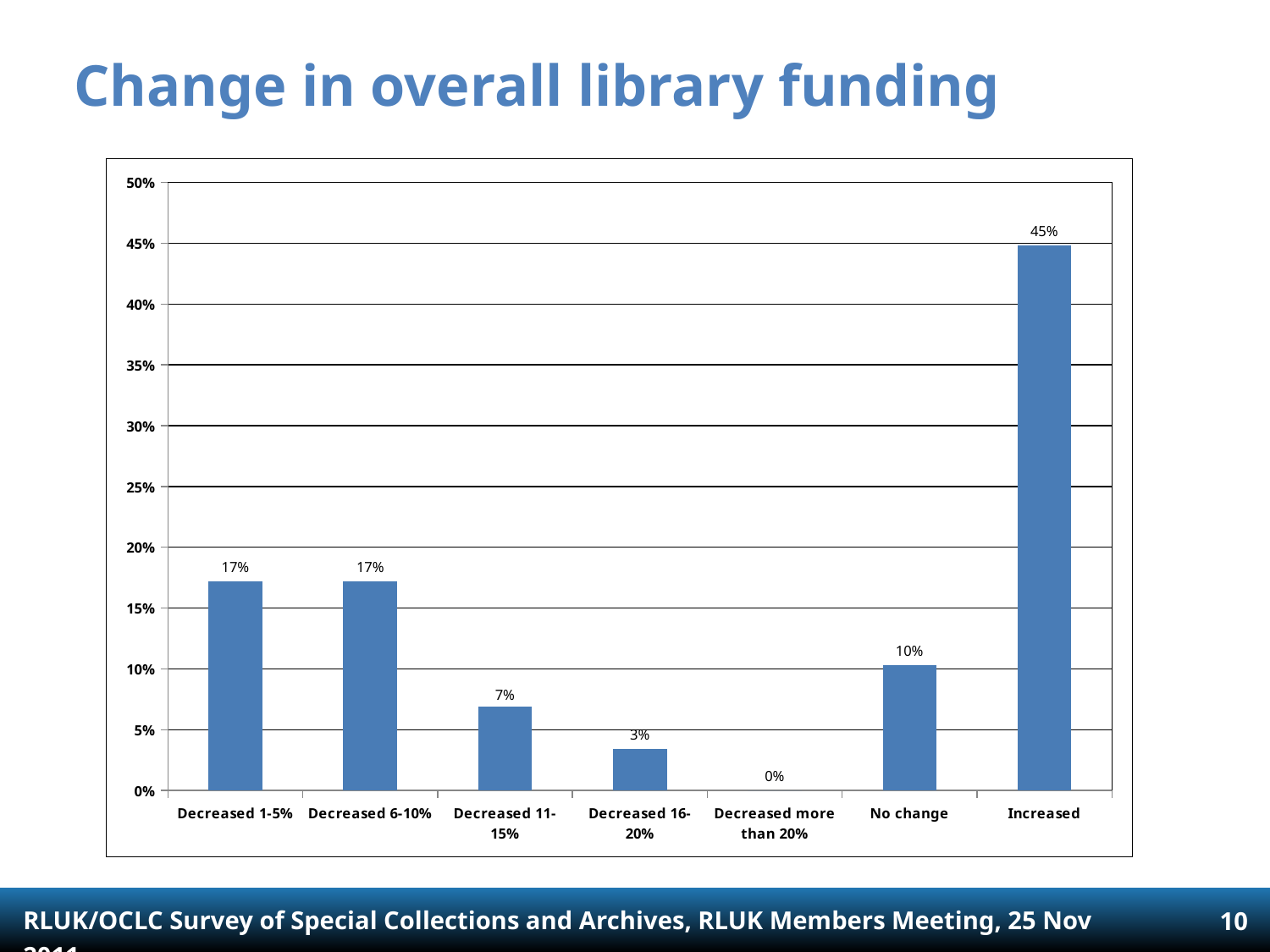
What is the value for Increased? 45% What is the difference between the values for Increased and No change? 35% Which is larger, the value for Decreased 1-5% or the value for No change? Decreased 1-5% What kind of chart is shown on the slide? bar chart What is the value for Decreased 11-15%? 7% Which category has the highest value? Increased How many categories are shown on the x axis? 7 Is the value for Increased greater or less than 40%? greater What is the difference between the values for Decreased 11-15% and Decreased 16-20%? 4% What is the value for Decreased more than 20%? 0% Which category has the lowest value? Decreased more than 20% What is the value for No change? 10%